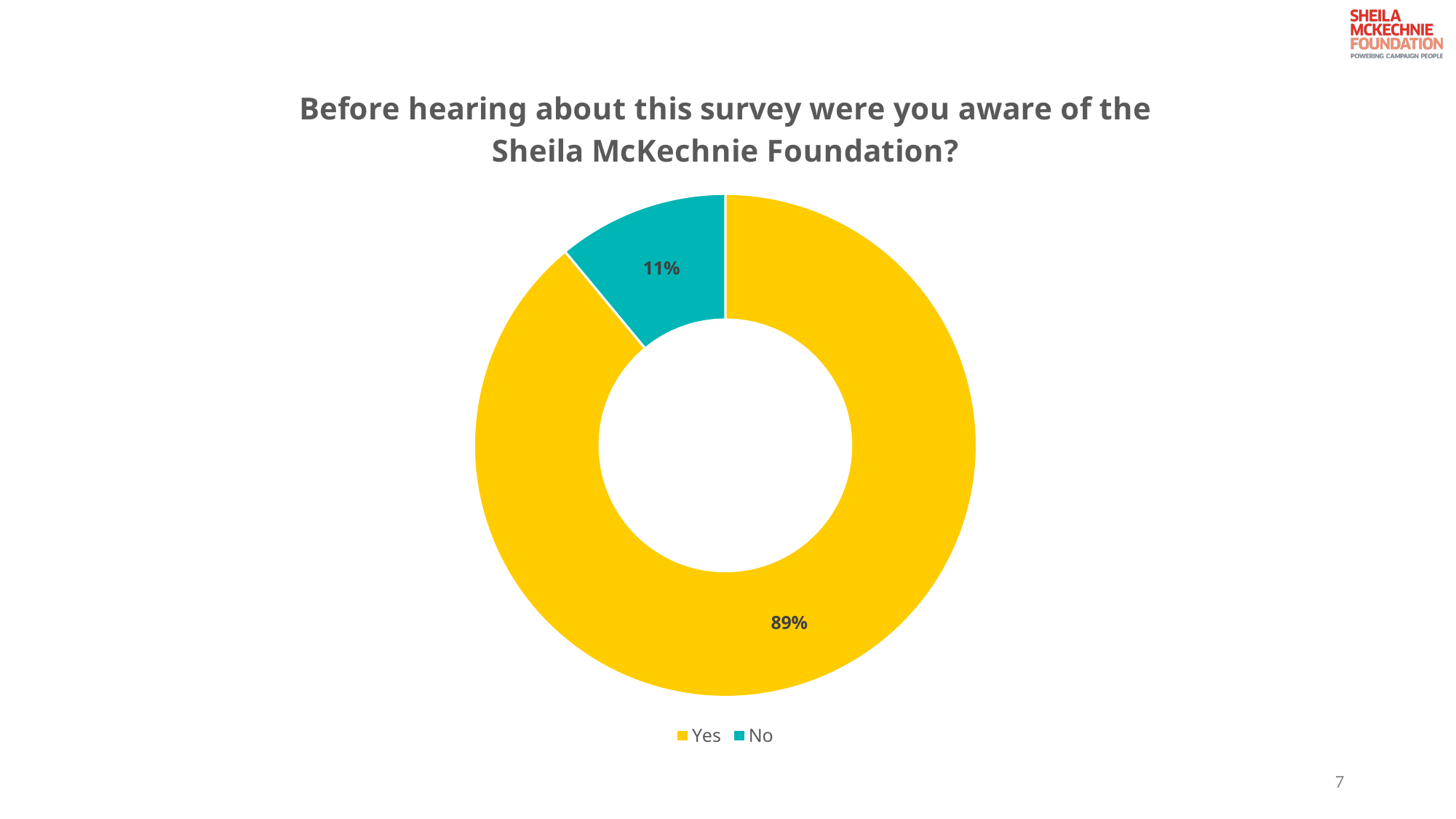
What kind of chart is shown on the slide? Doughnut (pie) chart What percentage of respondents answered Yes? 89% What colour is the Yes slice? Yellow What is the title of the chart? Before hearing about this survey were you aware of the Sheila McKechnie Foundation? Which response has the smallest share of the chart? No How many entries does the legend list? 2 What share of the chart does the No slice represent? 11% What percentage of respondents answered No? 11% Which response has the largest share of the chart? Yes What is the difference in percentage points between the Yes and No shares? 78 Which is larger, the share for Yes or the share for No? Yes How many categories does the chart show? 2